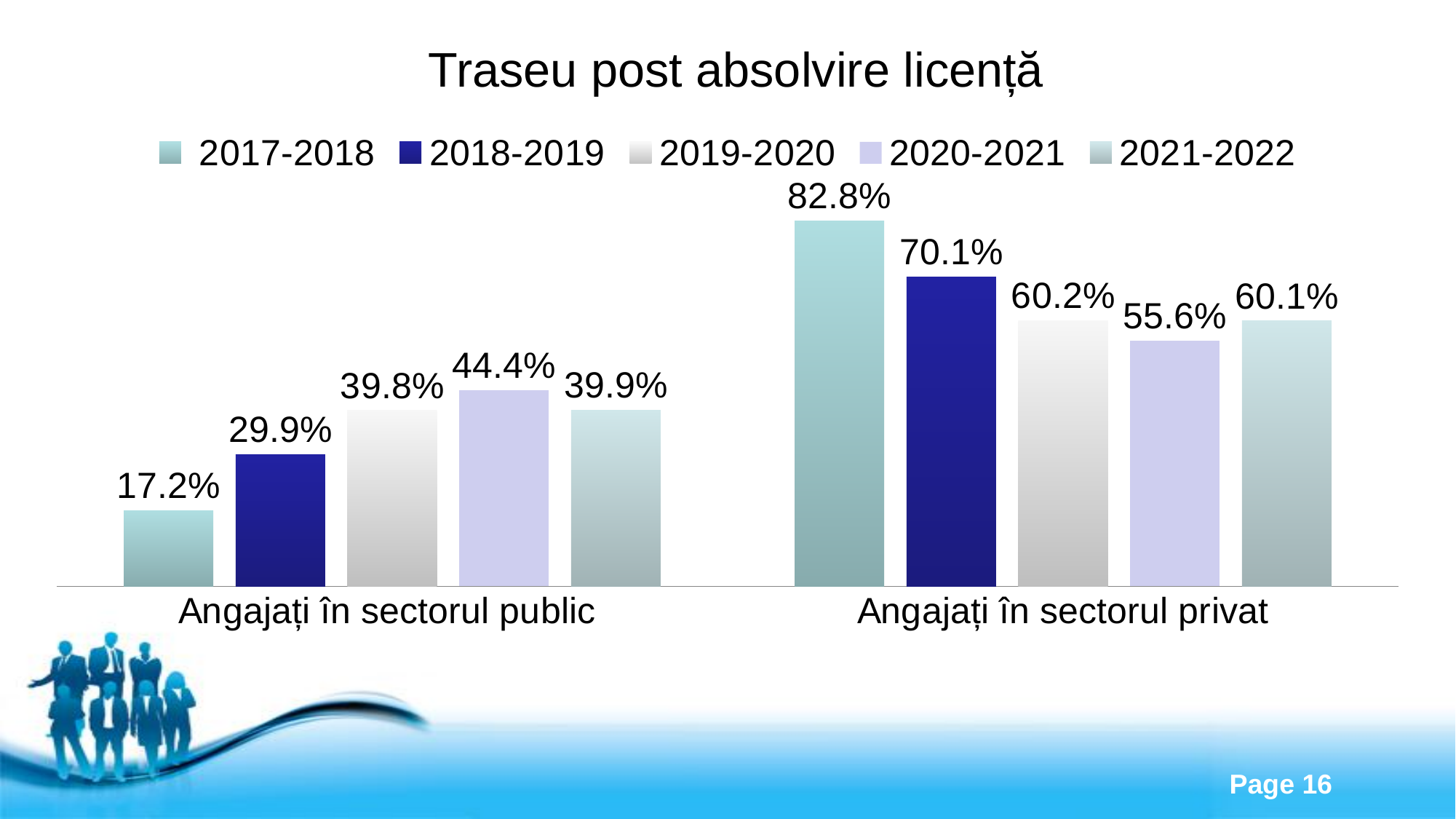
Which series has the highest value in the 'Angajați în sectorul privat' category? 2017-2018 What type of chart is shown on the slide? Bar chart What is the value for 2017-2018 in the 'Angajați în sectorul public' category? 17.2% What is the value for 2020-2021 in the 'Angajați în sectorul privat' category? 55.6% Which is larger: the 2020-2021 value for 'Angajați în sectorul public' or the 2019-2020 value for 'Angajați în sectorul public'? 2020-2021 Which series has the highest value in the 'Angajați în sectorul public' category? 2020-2021 What is the difference between the 2017-2018 values for 'Angajați în sectorul privat' and 'Angajați în sectorul public'? 65.6% How many series does the legend list? 5 What is the value for 2019-2020 in the 'Angajați în sectorul public' category? 39.8% How many categories are shown on the x axis? 2 Which series has the lowest value in the 'Angajați în sectorul public' category? 2017-2018 What is the difference between the 2018-2019 and 2017-2018 values in the 'Angajați în sectorul privat' category? 12.7%